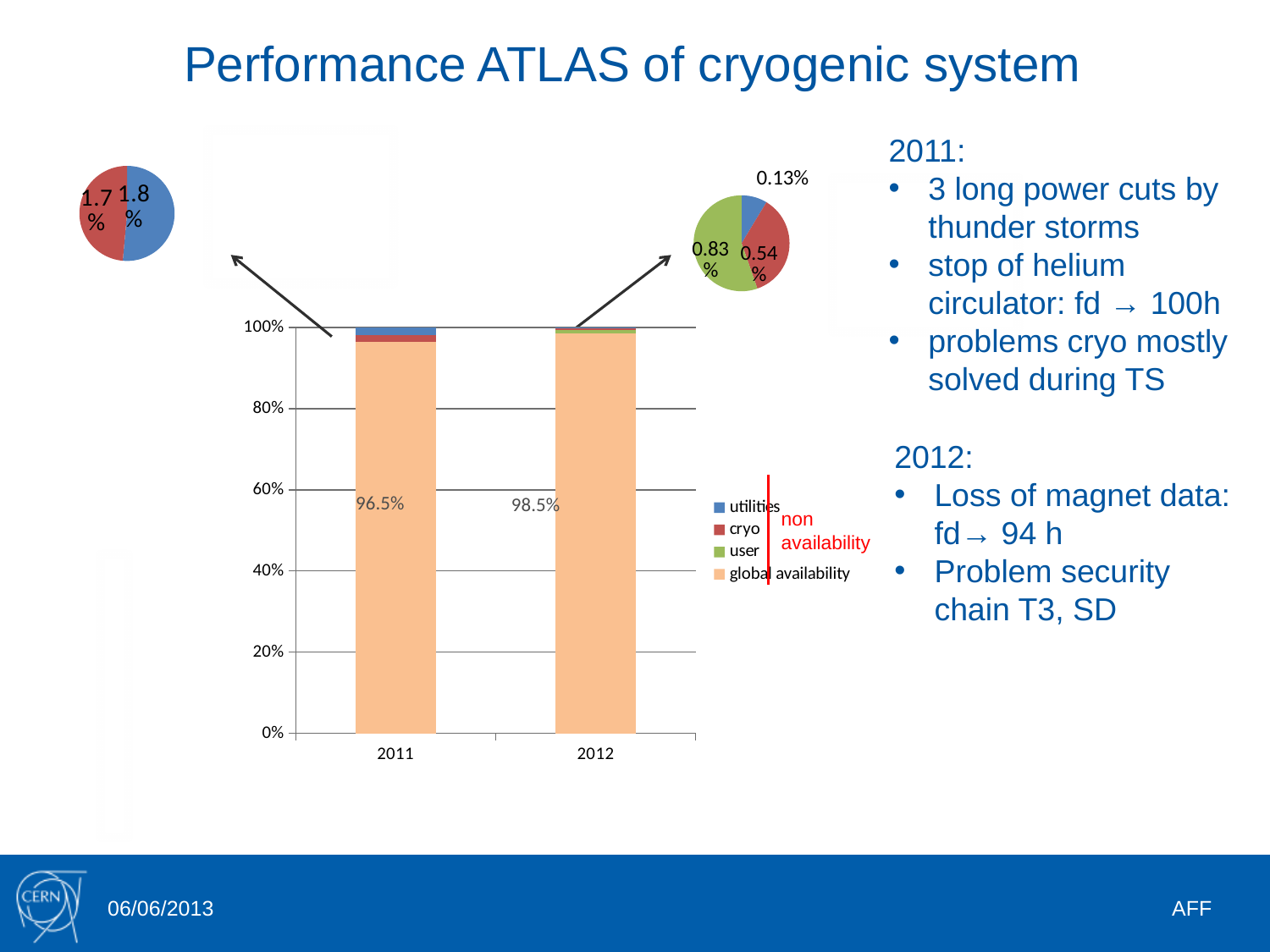
In the bar chart, what is the global availability value labelled for 2012? 98.5% In the bar chart, is the global availability for 2011 greater or less than 80%? greater In the bar chart, what is the global availability value labelled for 2011? 96.5% In the bar chart, which year has the higher global availability, 2011 or 2012? 2012 In the pie chart on the right (for 2012), what is the value of the largest slice? 0.83% What kind of chart is the large chart in the centre of the slide? Stacked bar chart How many years are shown on the x axis of the bar chart? 2 In the bar chart legend, which series is shown in orange? global availability In the bar chart, does global availability rise or fall from 2011 to 2012? Rises In the pie chart on the right (for 2012), what is the value of the smallest slice? 0.13% In the bar chart, what is the difference between the global availability of 2012 and 2011? 2.0% How many series does the legend of the bar chart list? 4